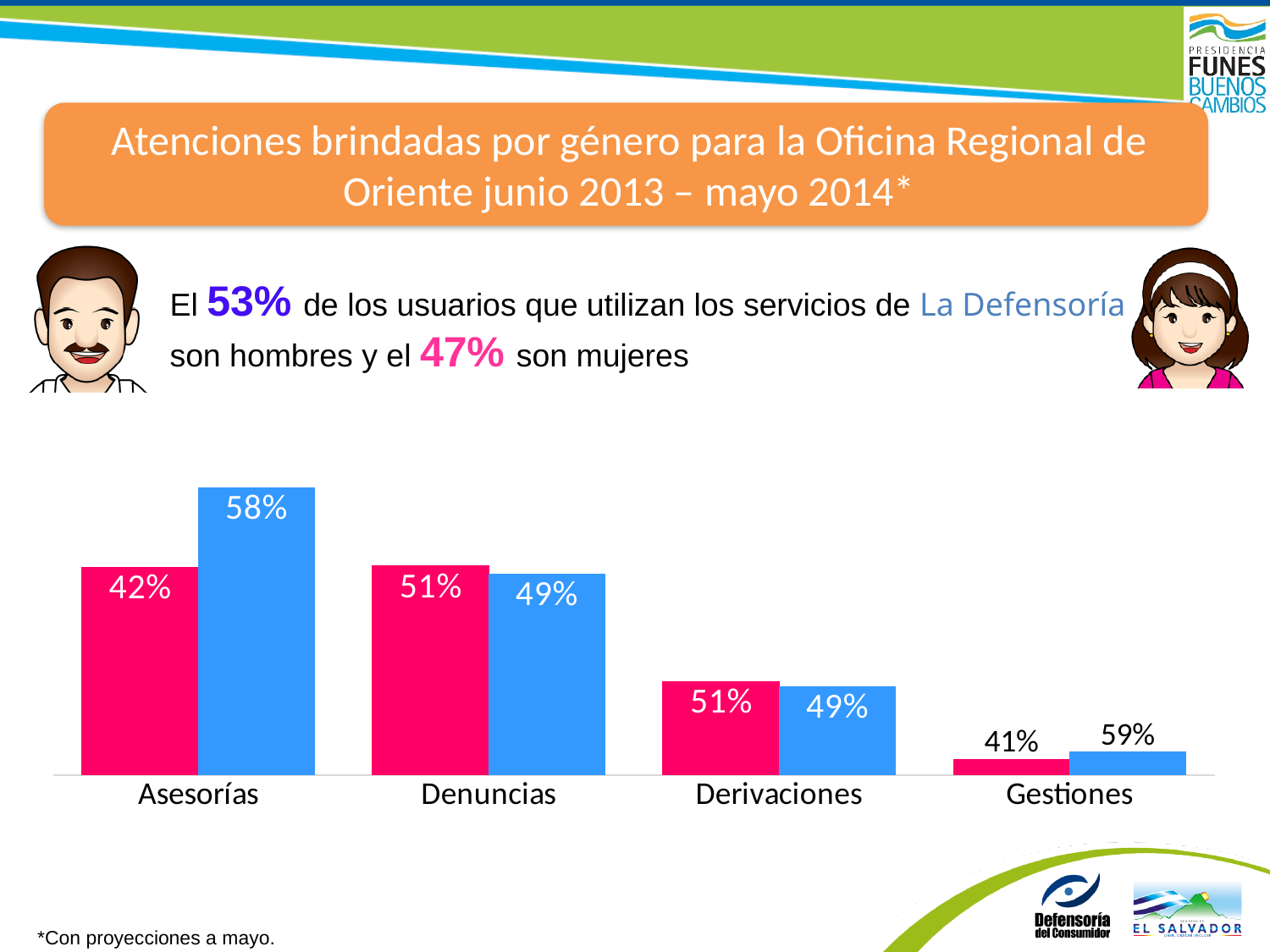
What kind of chart is shown on the slide? bar chart What is the value of the pink bar for Asesorías? 42% What is the value of the pink bar for Gestiones? 41% What are the two bar colours used in the chart? pink and blue What is the difference between the blue bar and the pink bar for Asesorías? 16 percentage points What is the value of the blue bar for Derivaciones? 49% What is the value of the pink bar for Denuncias? 51% What is the value of the blue bar for Gestiones? 59% How many categories are shown on the x axis of the chart? 4 Which category has the lowest pink bar value? Gestiones What is the value of the blue bar for Asesorías? 58% For Asesorías, which bar has the larger value, the pink bar or the blue bar? the blue bar